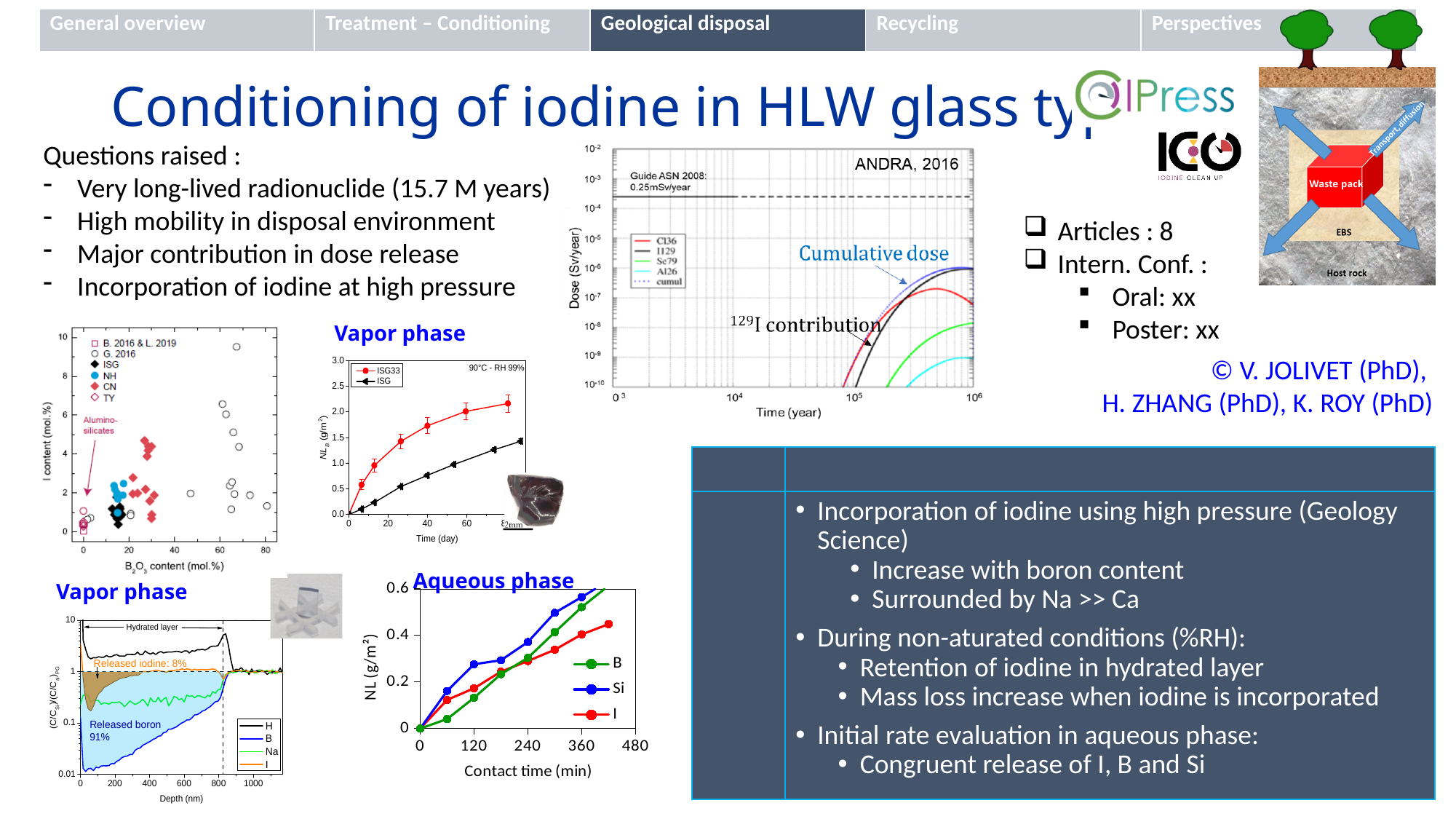
In the ANDRA, 2016 dose chart, how many entries does the legend list? 5 In the bottom Vapor phase depth-profile chart, how many series does the legend list? 4 In the top Vapor phase chart (NL_B vs Time), is the value for ISG at 40 days greater or less than 1.0? less In the Aqueous phase chart, is the value for I at 360 min greater or less than 0.6? less In the ANDRA, 2016 dose chart, which series reaches a higher peak dose, Cl36 or Se79? Cl36 In the top Vapor phase chart (NL_B vs Time), what temperature and relative humidity condition is printed on the chart? 90°C - RH 99% In the Aqueous phase chart, do the NL values rise or fall as contact time increases? rise In the top Vapor phase chart (NL_B vs Time), which series has the higher value at 80 days, ISG33 or ISG? ISG33 In the Aqueous phase chart, which series has the higher value at 120 min, Si or B? Si In the Aqueous phase chart, how many series does the legend list? 3 In the Aqueous phase chart, is the value for Si at 360 min greater or less than 0.4? greater In the Aqueous phase chart, what kind of chart is shown? line chart